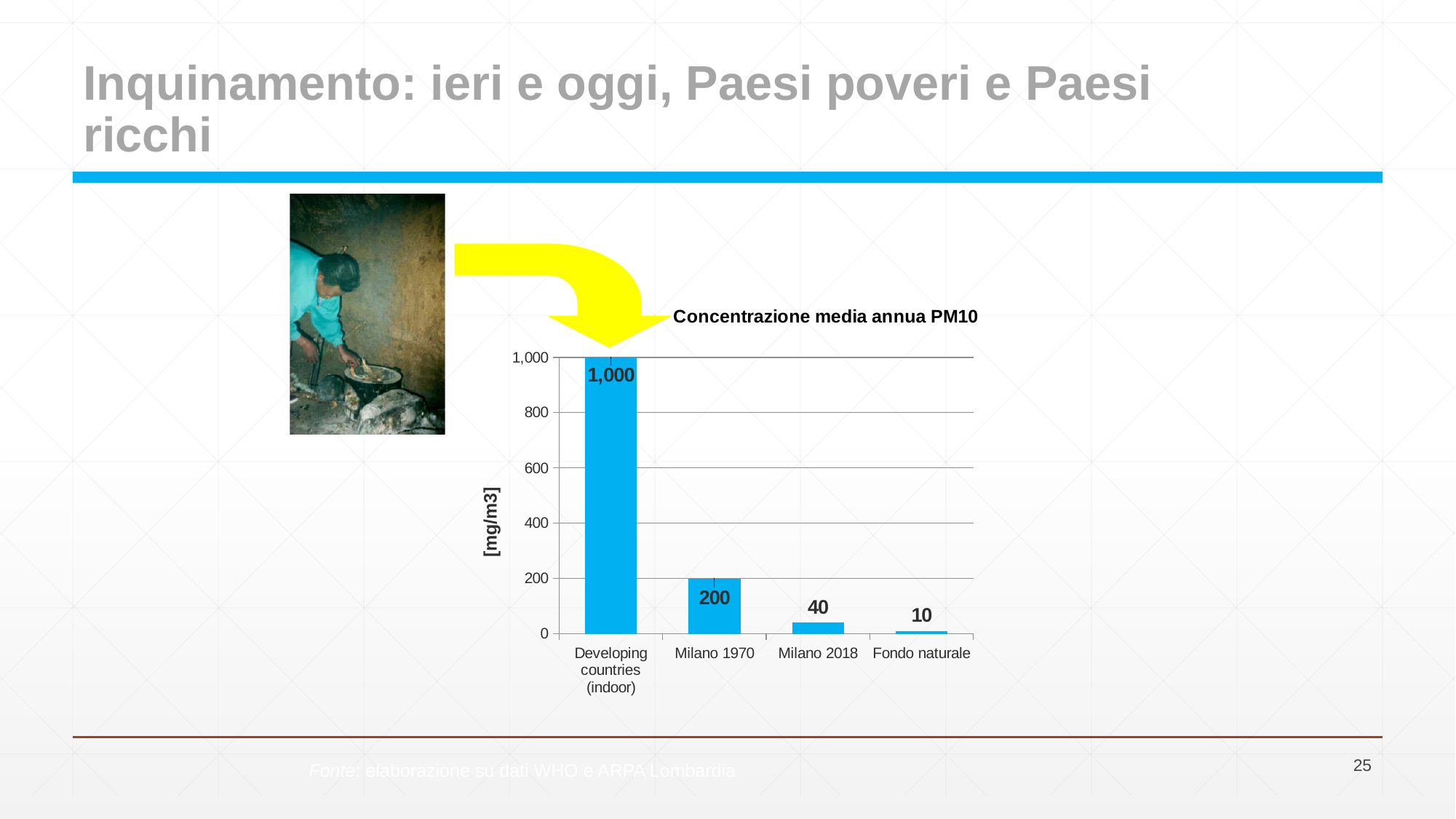
What is the value for Milano 2018? 40 What kind of chart is shown on the slide? Bar chart Do the values rise or fall from left to right along the x axis? Fall How many categories are shown on the x axis? 4 Which category has the highest value? Developing countries (indoor) What is the value for Developing countries (indoor)? 1,000 Which is larger, the value for Milano 2018 or the value for Fondo naturale? Milano 2018 Which category has the lowest value? Fondo naturale What is the difference between the values for Milano 1970 and Milano 2018? 160 What is the value for Milano 1970? 200 What is the title of the chart? Concentrazione media annua PM10 What is the value for Fondo naturale? 10